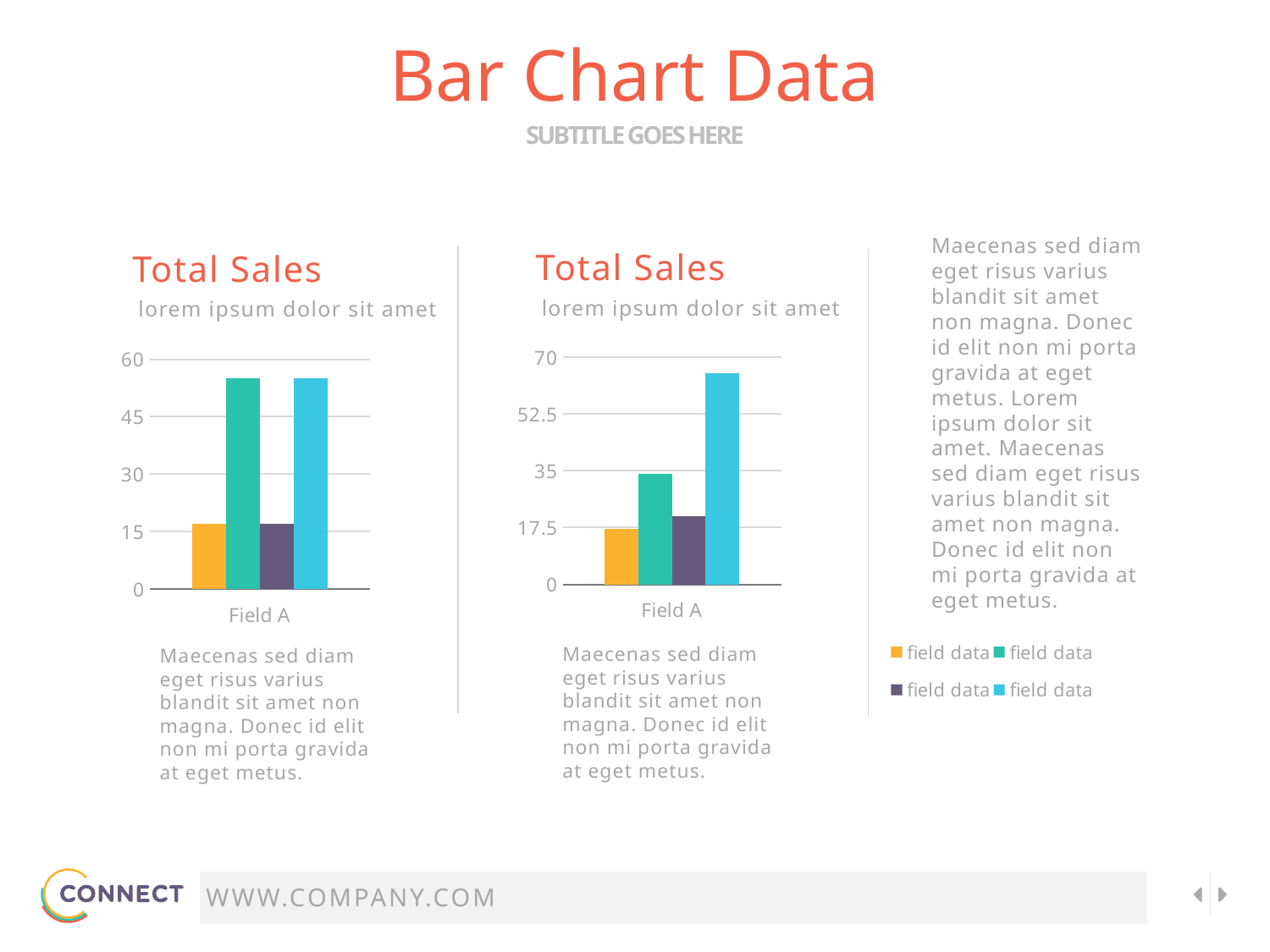
What is the title of the left chart? Total Sales In the right chart, is the value of the light blue bar greater or less than 52.5? greater What kind of chart is the right chart on the slide? bar chart What is the category label on the x axis of the right chart? Field A In the right chart, which is larger, the green bar or the light blue bar? the light blue bar How many series does the legend on the slide list? 4 In the left chart, is the value of the green bar greater or less than 45? greater How many categories are shown on the x axis of the left chart? 1 In the left chart, is the value of the orange bar greater or less than 30? less In the right chart, which bar is the highest? the light blue bar What kind of chart is the left chart on the slide? bar chart